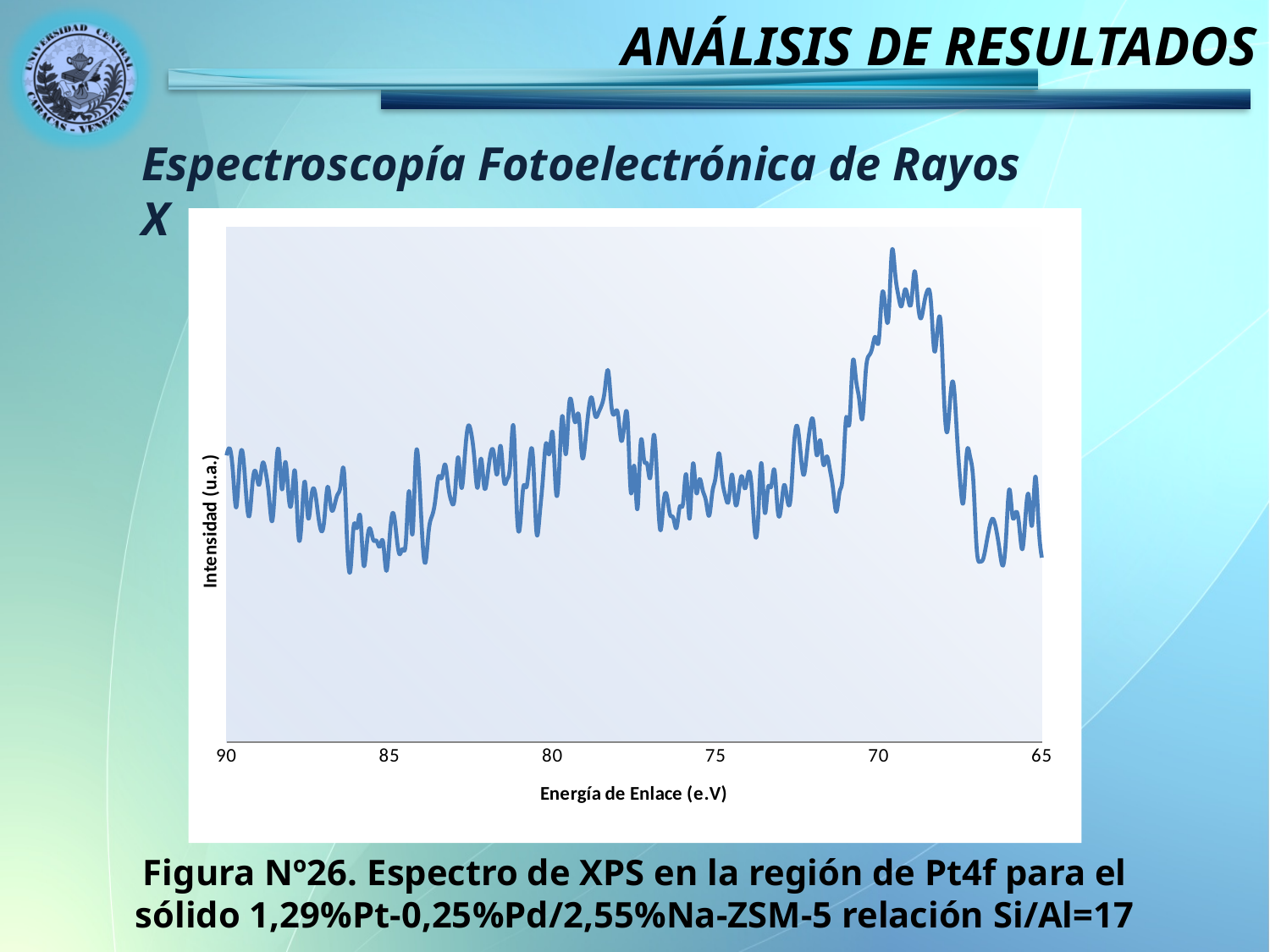
Is the intensity near 70 eV higher or lower than the intensity near 85 eV? Higher How many tick labels are shown on the x axis of the chart? 6 Is the intensity near 80 eV higher or lower than the intensity near 70 eV? Lower What is the leftmost x-axis tick value on the chart? 90 What is the label of the y axis of the chart? Intensidad (u.a.) Do the x-axis tick values increase or decrease from left to right? Decrease What is the label of the x axis of the chart? Energía de Enlace (e.V) How many data series are plotted in the chart? 1 What kind of chart is shown on the slide? Line chart Near which labeled x-axis value does the highest peak of the spectrum occur? 70 What is the rightmost x-axis tick value on the chart? 65